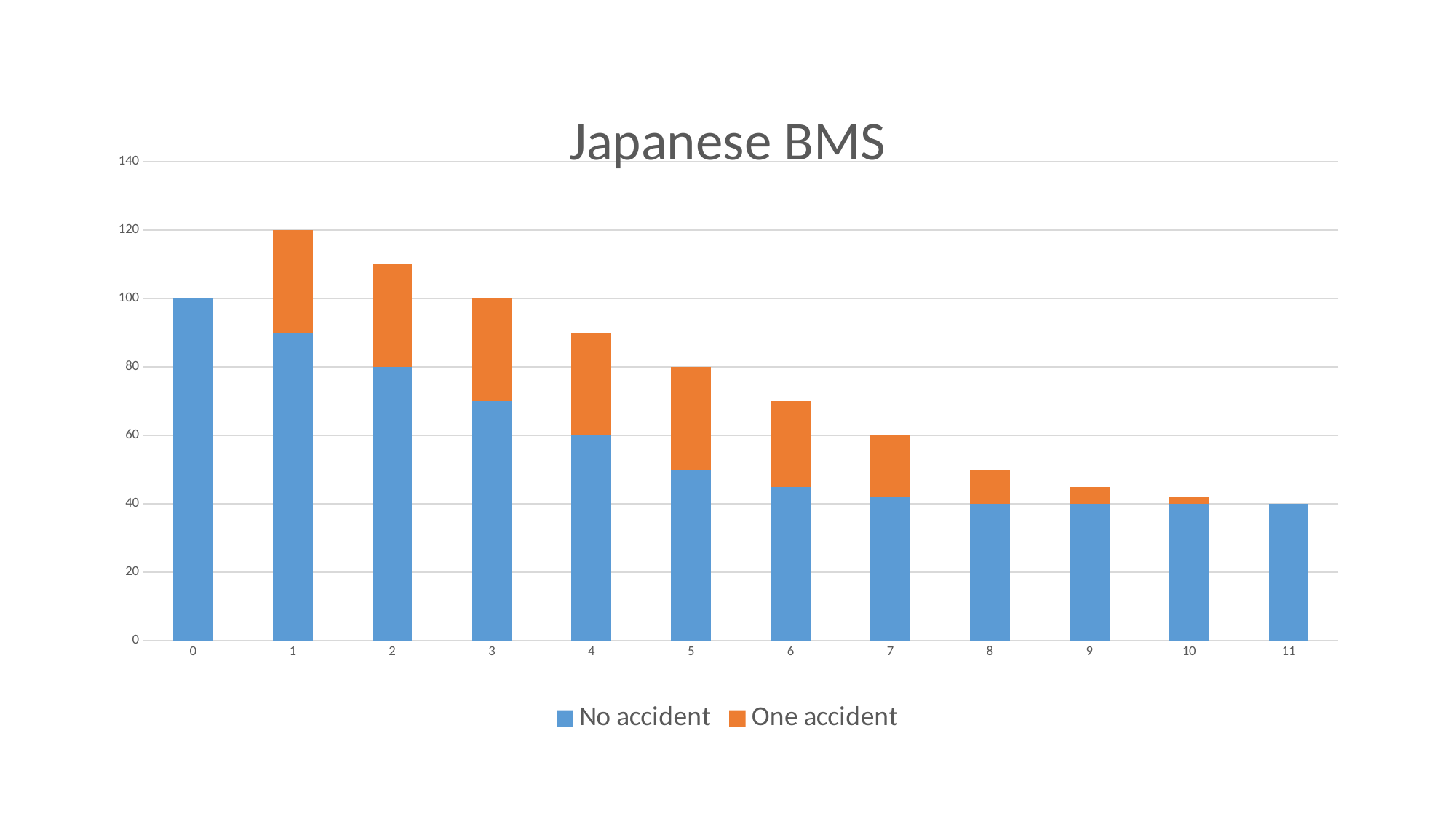
How many series does the legend list? 2 What is the No accident value for category 0? 100 What is the No accident value for category 2? 80 Which category has the highest No accident value? 0 What is the total height of the stacked bar for category 1? 120 What type of chart is shown on the slide? bar chart Which category has the highest total stacked bar? 1 Do the total bar heights generally rise or fall from category 1 to category 11? fall What is the title of the chart? Japanese BMS What is the value for category 11? 40 How many categories are shown on the x axis? 12 Is the total for category 6 greater or less than 60? greater